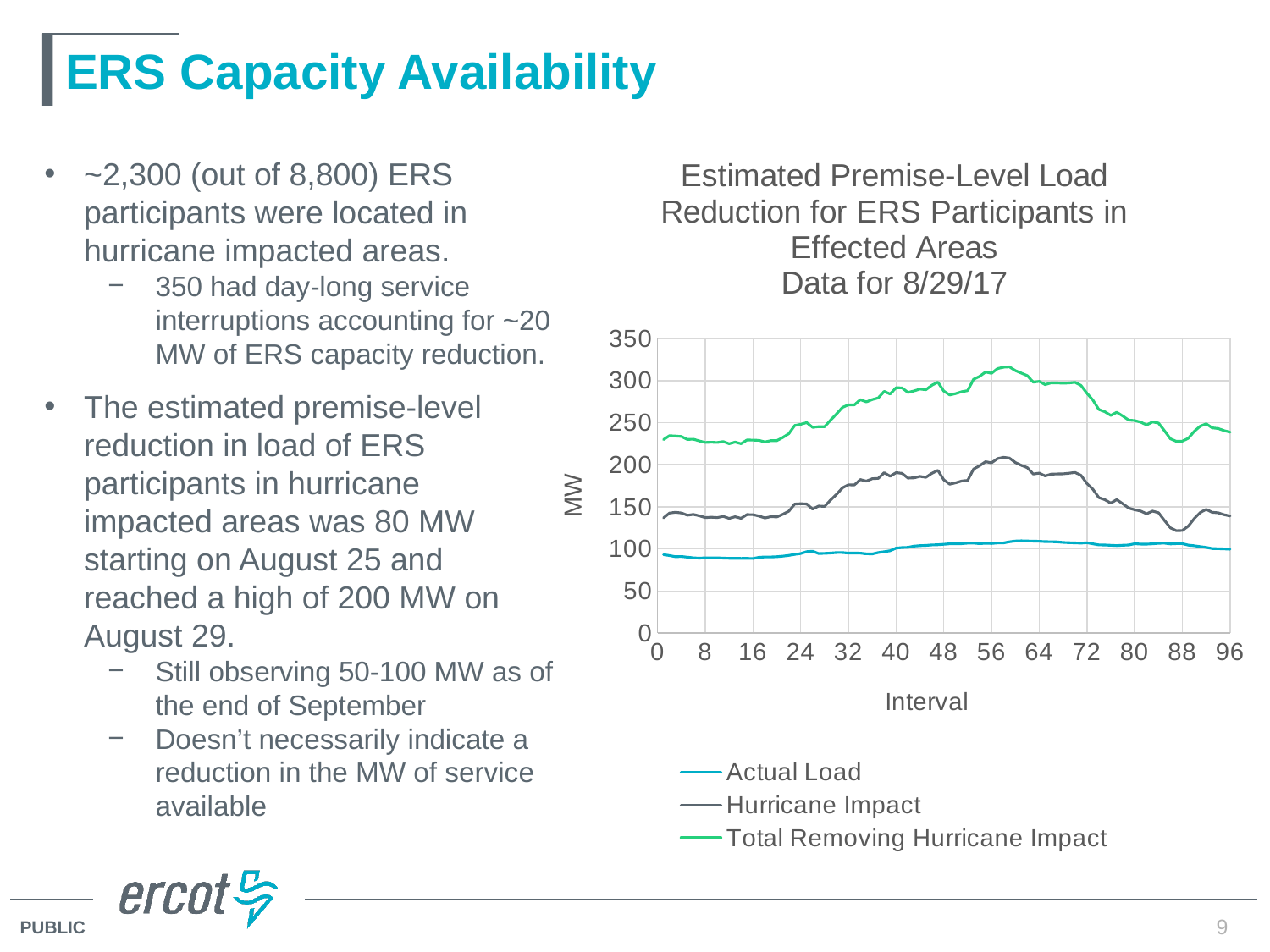
At interval 56, which is larger: Total Removing Hurricane Impact or Hurricane Impact? Total Removing Hurricane Impact Which series has the lowest values across the chart? Actual Load Is the peak value of Total Removing Hurricane Impact greater or less than 300? greater How many series does the chart legend list? 3 Is the peak value of Hurricane Impact greater or less than 150? greater What kind of chart is shown on the slide? line chart What are the three series listed in the chart legend? Actual Load, Hurricane Impact, Total Removing Hurricane Impact Which series has the highest values across the chart? Total Removing Hurricane Impact Is the value of Total Removing Hurricane Impact at interval 0 greater or less than 200? greater What is the label of the chart's y axis? MW Does the Hurricane Impact series generally rise or fall between interval 0 and interval 56? rise